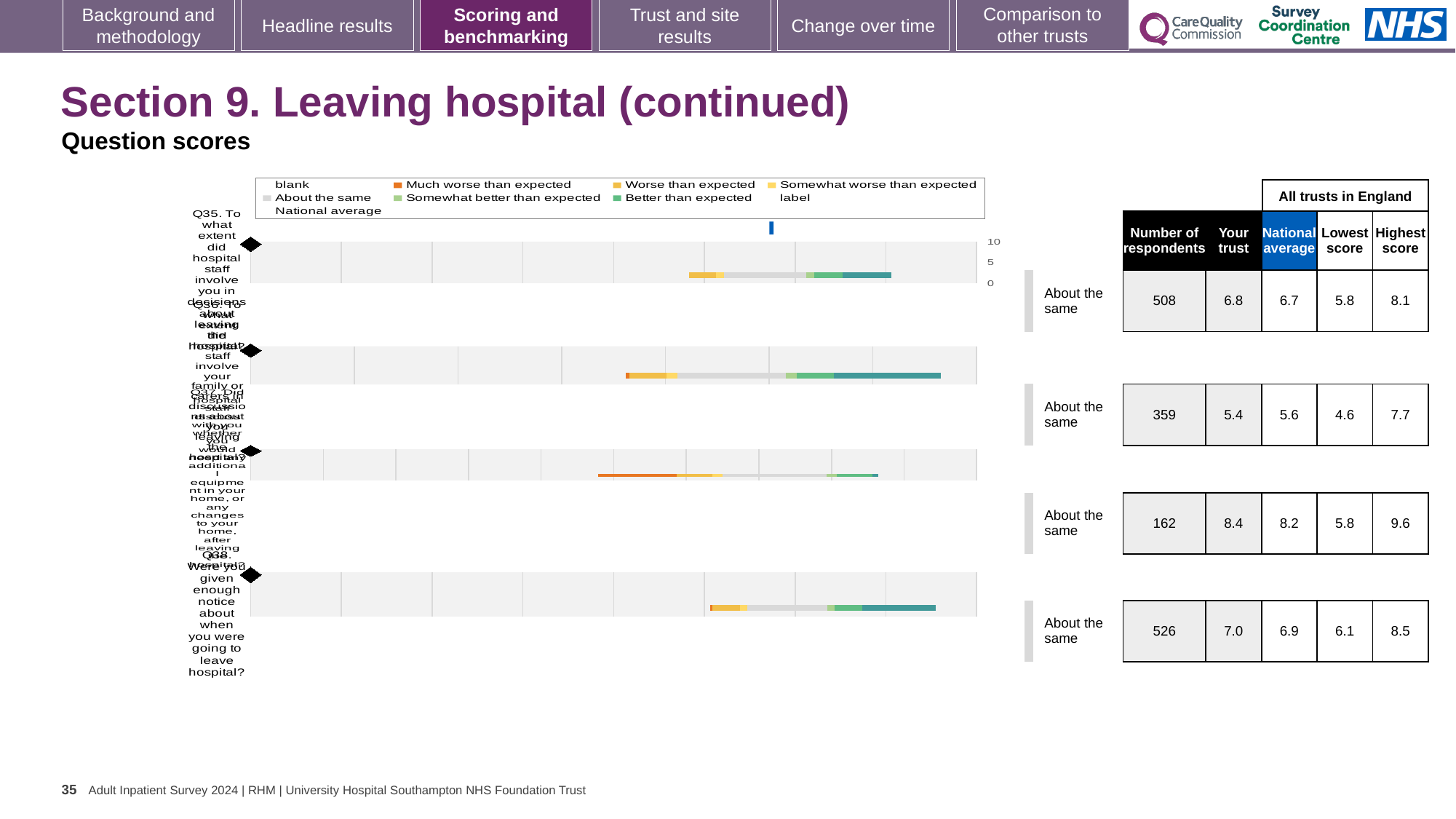
What benchmark category is shown for Q38? About the same What is the national average score for Q38? 6.9 What colour does the legend use for "Much worse than expected"? orange What is the lowest score across all trusts in England for Q35? 5.8 What is the "Your trust" score for Q38 (given enough notice about when you were going to leave hospital)? 7.0 How many question bars are plotted in the chart? 4 What does the blue marker in the legend represent? National average Which is larger for Q35: the "Your trust" score or the national average? Your trust What kind of chart is shown on the slide? bar chart Which question row has the highest "Your trust" score? the third row (8.4) What is the difference between the highest score and the lowest score for Q38? 2.4 What is the number of respondents for Q35 (involving you in decisions about leaving hospital)? 508